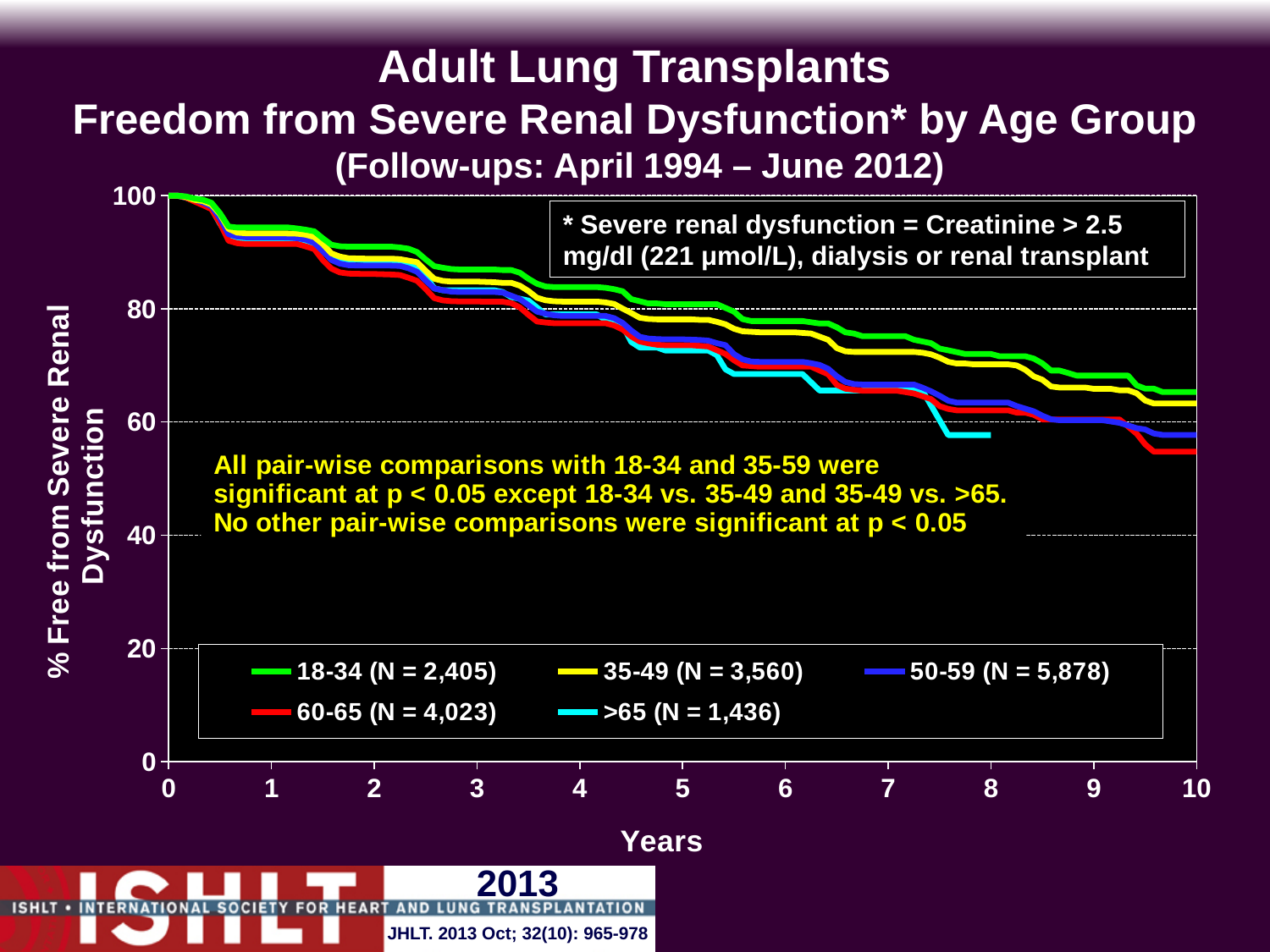
At 10 years, which group has the higher value: 18-34 or 60-65? 18-34 Is the value for the 18-34 group at 2 years greater or less than 80? greater Is the value for the 18-34 group at 10 years greater or less than 60? greater What is the N for the 50-59 age group shown in the legend? 5,878 Which age group has the lowest freedom from severe renal dysfunction at 10 years? 60-65 What kind of chart is shown on the slide? line chart How many age groups does the legend list? 5 What is the follow-up period given in the chart title? April 1994 – June 2012 Do the curves rise or fall as the years increase? fall Is the value for the 60-65 group at 10 years greater or less than 60? less Which age group has the highest freedom from severe renal dysfunction at 10 years? 18-34